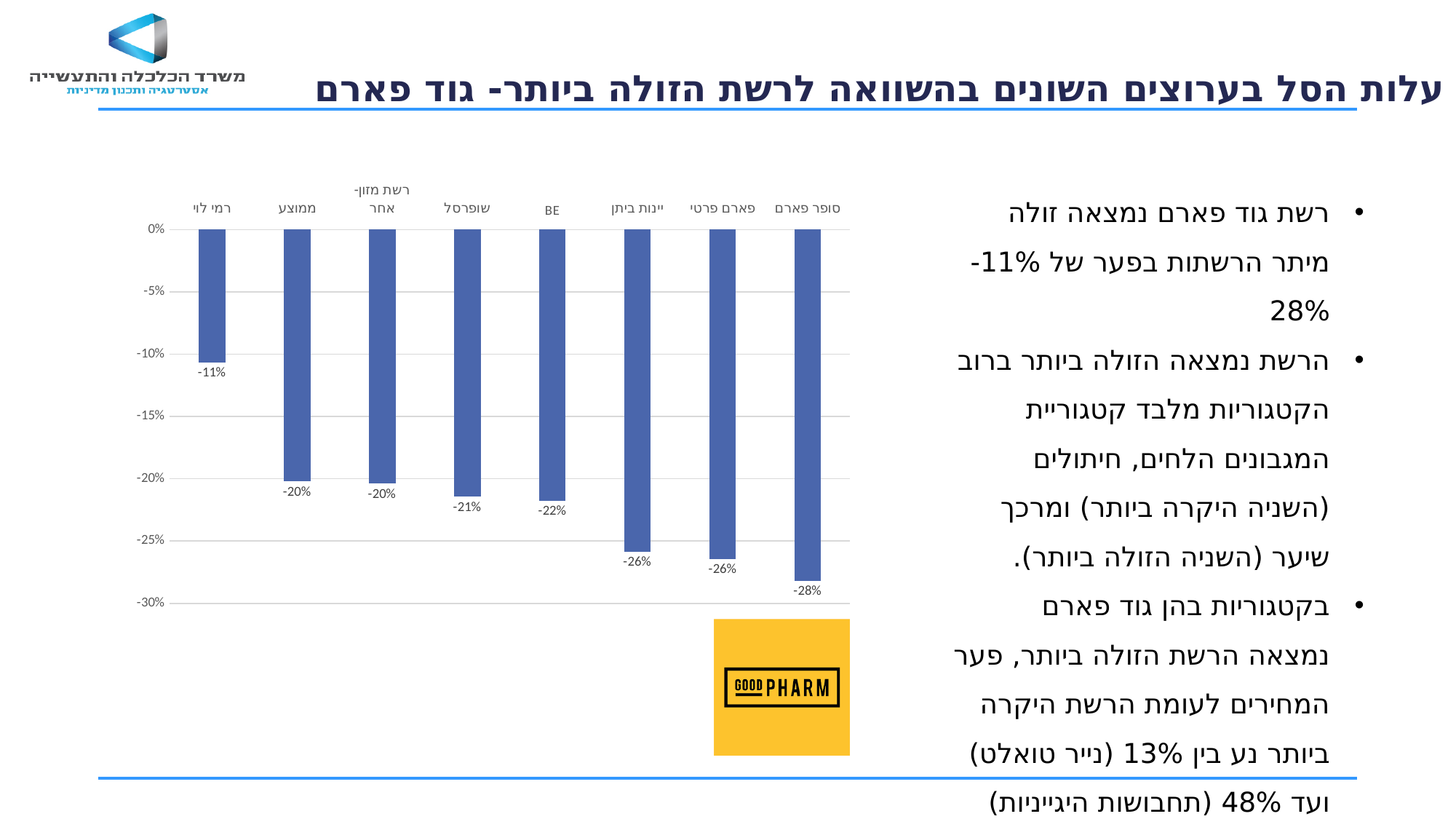
Which category has the largest negative value (the longest bar) in the chart? סופר פארם What is the value shown for סופר פארם in the bar chart? -28% How many categories are shown in the bar chart? 8 Which bar extends further below zero: יינות ביתן or שופרסל? יינות ביתן Which category has the value closest to zero (the shortest bar) in the chart? רמי לוי What type of chart is shown on the slide? Bar chart What is the value shown for רמי לוי in the bar chart? -11% What is the value shown for שופרסל in the bar chart? -21% What is the value shown for BE in the bar chart? -22% What is the difference between the values for סופר פארם and רמי לוי? 17 percentage points What is the value shown for ממוצע in the bar chart? -20% What is the lowest tick value shown on the vertical axis of the chart? -30%